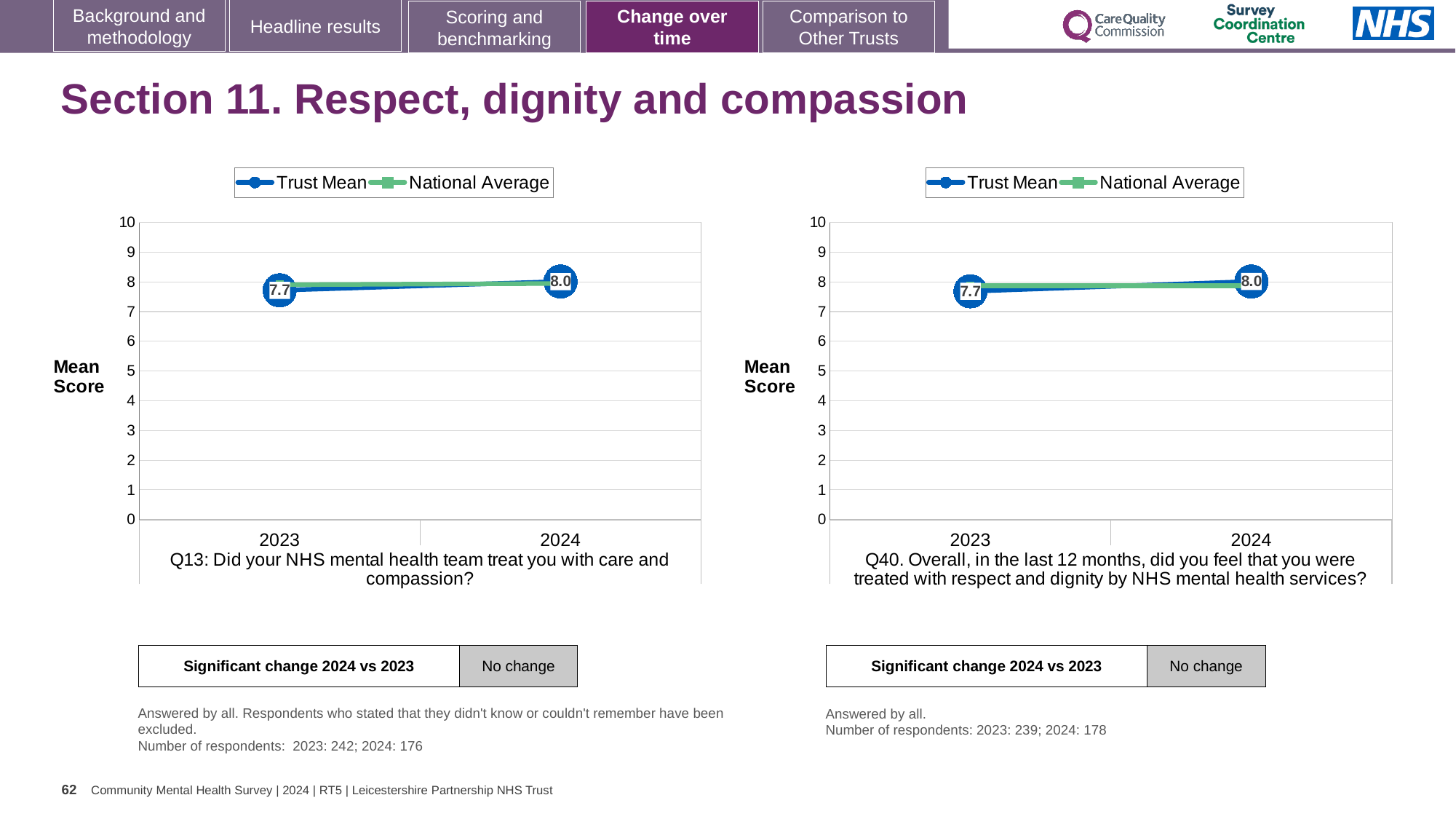
In the left chart (Q13), by how much did the Trust Mean change from 2023 to 2024? 0.3 In the left chart (Q13), what is the Trust Mean for 2024? 8.0 What kind of chart is the left chart (Q13)? line chart What is the label on the y axis of the right chart (Q40)? Mean Score How many series does the legend of the left chart (Q13) list? 2 In the right chart (Q40), what is the Trust Mean for 2024? 8.0 In the right chart (Q40), does the Trust Mean rise or fall from 2023 to 2024? rise In the right chart (Q40), is the Trust Mean for 2023 greater or less than 5? greater How many years are plotted on the x axis of the right chart (Q40)? 2 In the right chart (Q40), what is the Trust Mean for 2023? 7.7 In the left chart (Q13), what is the Trust Mean for 2023? 7.7 In the left chart (Q13), which year has the higher Trust Mean, 2023 or 2024? 2024